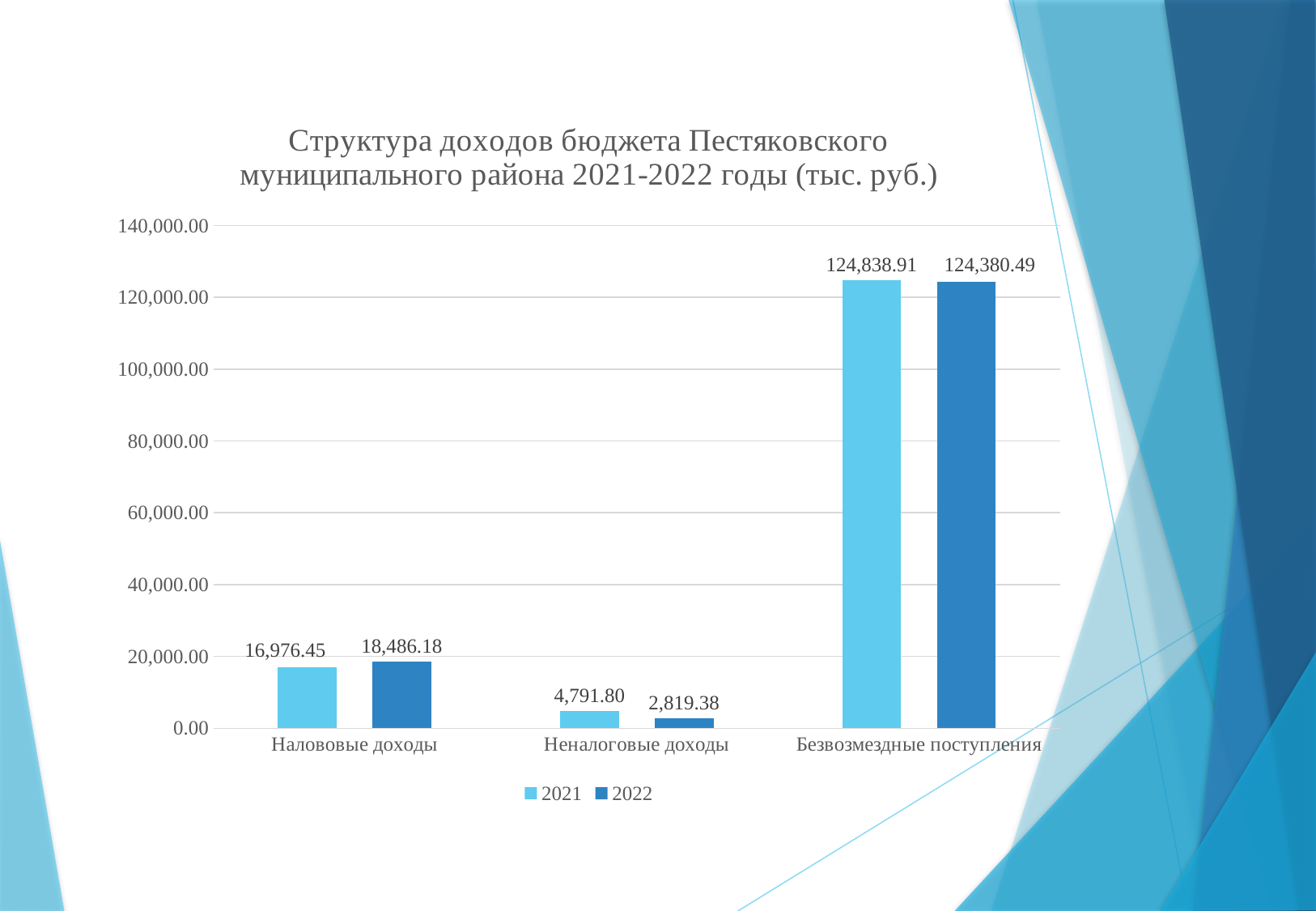
Which category has the lowest value in 2021? Неналоговые доходы Is the 2022 value for Налововые доходы greater or less than 20,000.00? less What is the difference between the 2022 and 2021 values for Налововые доходы? 1,509.73 What is the value for Неналоговые доходы in 2022? 2,819.38 What is the difference between the 2021 and 2022 values for Неналоговые доходы? 1,972.42 For Безвозмездные поступления, which year has the larger value, 2021 or 2022? 2021 How many series does the legend list? 2 What is the value for Безвозмездные поступления in 2021? 124,838.91 What is the value for Налововые доходы in 2021? 16,976.45 Which category has the highest value in 2022? Безвозмездные поступления What type of chart is shown on the slide? Bar chart How many categories are shown on the x axis? 3